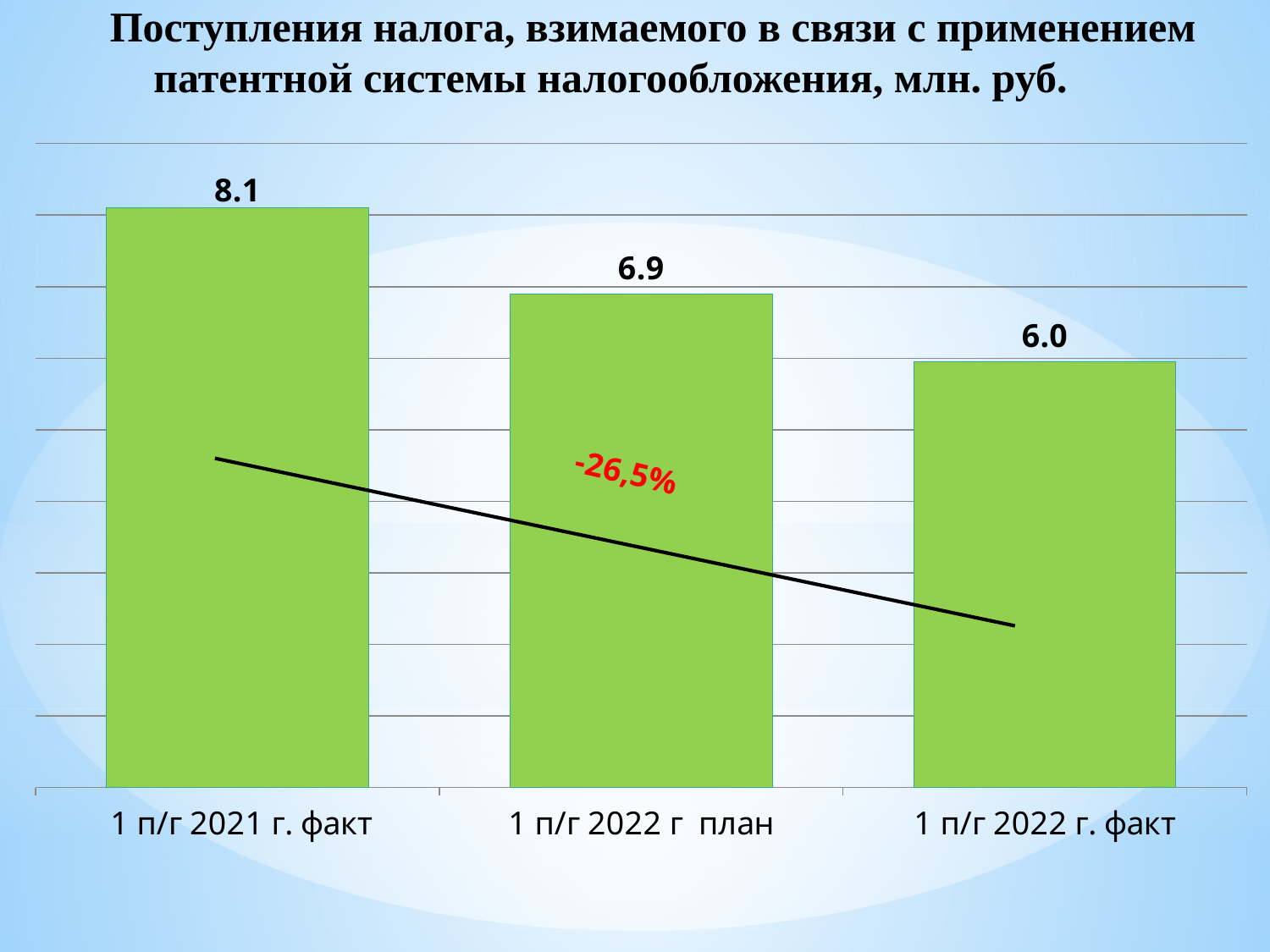
What percentage change is printed in red on the chart? -26,5% What is the value for 1 п/г 2022 г план? 6.9 Do the values rise or fall from left to right along the x axis? Fall What kind of chart is shown on the slide? Bar chart How many categories are shown on the chart? 3 What is the difference between the values for 1 п/г 2022 г план and 1 п/г 2022 г. факт? 0.9 What is the difference between the values for 1 п/г 2021 г. факт and 1 п/г 2022 г. факт? 2.1 What is the value for 1 п/г 2022 г. факт? 6.0 Which category has the lowest value? 1 п/г 2022 г. факт Which is larger, the value for 1 п/г 2022 г план or 1 п/г 2022 г. факт? 1 п/г 2022 г план What is the value for 1 п/г 2021 г. факт? 8.1 Which category has the highest value? 1 п/г 2021 г. факт